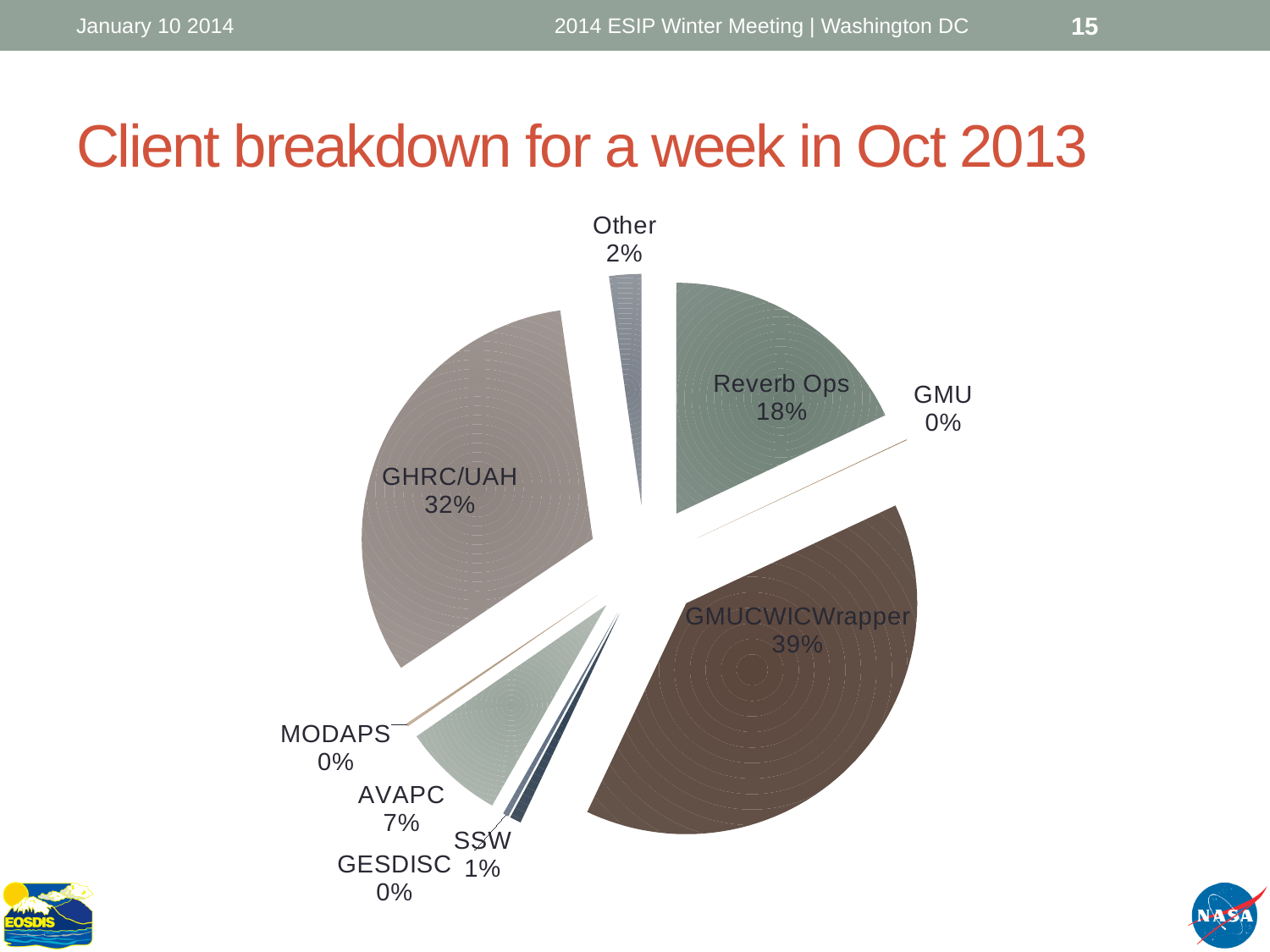
How many slices (categories) are labelled on the pie chart? 9 What percentage is shown for Reverb Ops? 18% What is the difference in percentage points between GMUCWICWrapper and GHRC/UAH? 7 What kind of chart is shown on the slide? pie chart What share of the pie does GMUCWICWrapper have? 39% What percentage is shown for SSW? 1% Which is larger, the share for Reverb Ops or the share for AVAPC? Reverb Ops What share of the pie does GHRC/UAH have? 32% What percentage is shown for Other? 2% What percentage is shown for AVAPC? 7% Which client has the largest share of the pie? GMUCWICWrapper What is the title of the chart on the slide? Client breakdown for a week in Oct 2013